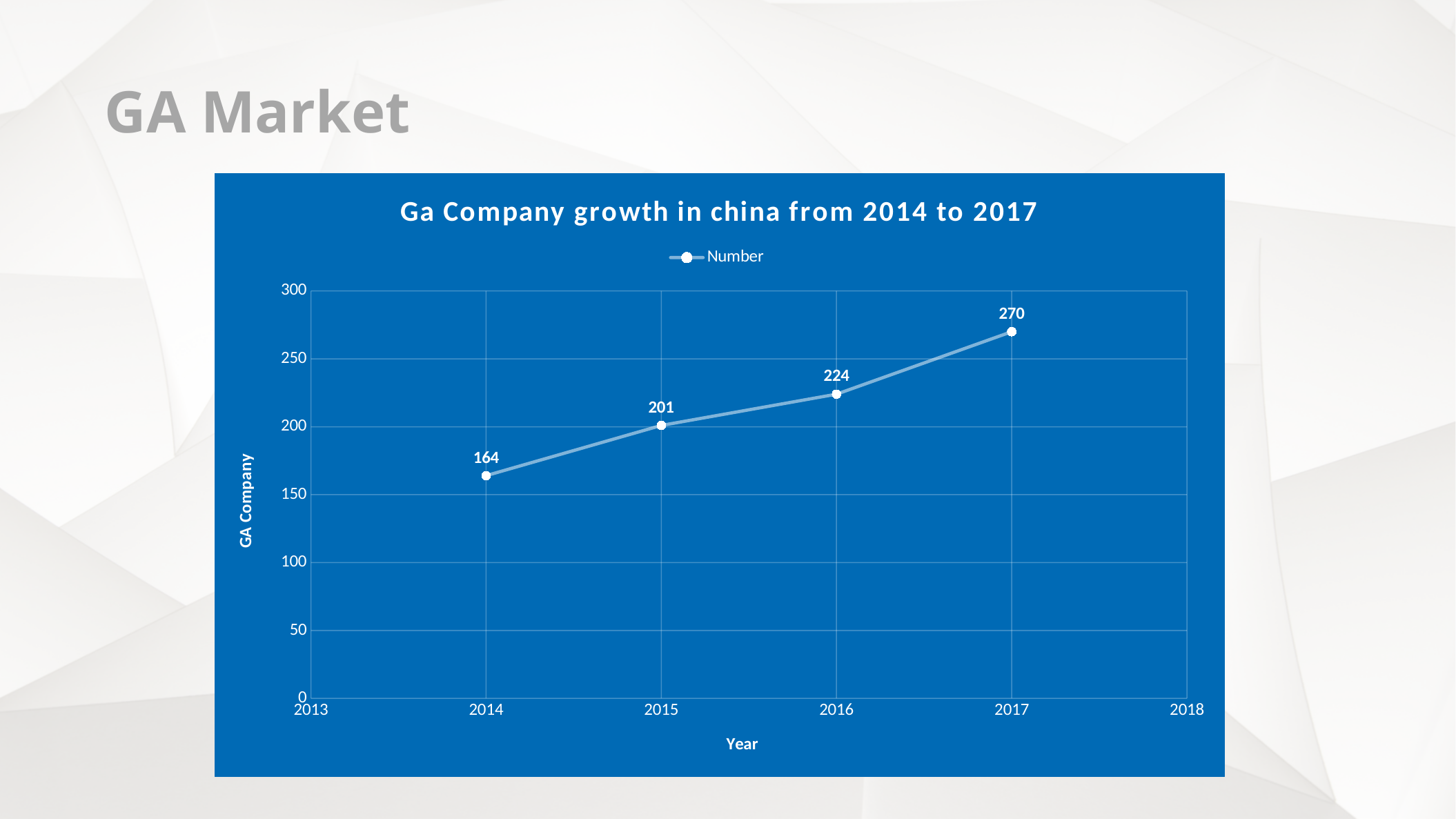
What is the value for 2016? 224 How many data points are plotted on the chart? 4 Do the values rise or fall from 2014 to 2017? rise What is the value for 2017? 270 What is the difference between the values for 2017 and 2014? 106 What is the difference between the values for 2015 and 2014? 37 Which year has the lowest value? 2014 Is the value for 2015 greater or less than 250? less What kind of chart is shown on the slide? line chart Which year has the highest value? 2017 Which is larger, the value for 2015 or the value for 2016? 2016 What is the value for 2014? 164